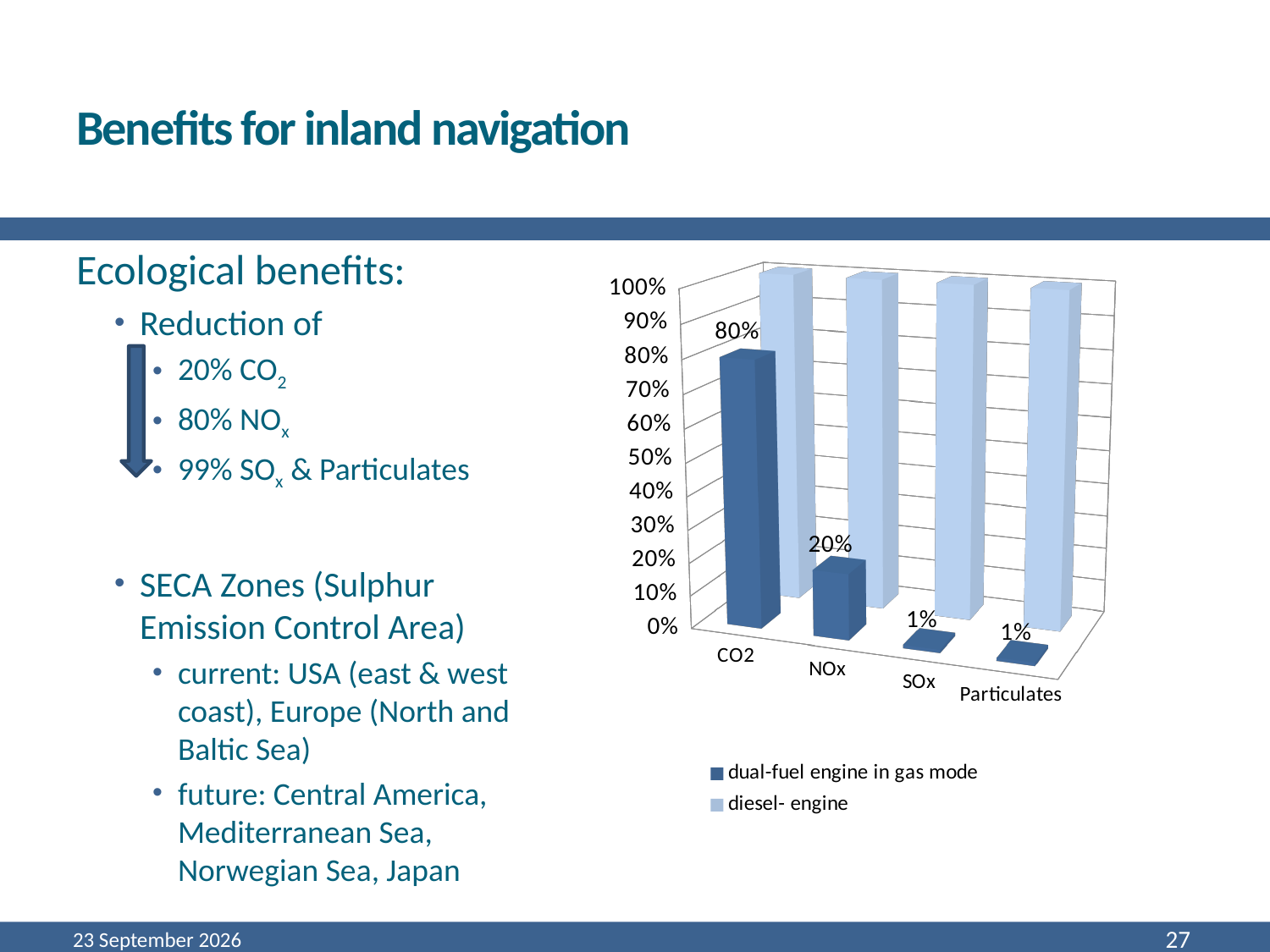
Do the dual-fuel engine in gas mode values rise or fall from CO2 to Particulates along the x axis? fall Which category has the highest value in the dual-fuel engine in gas mode series? CO2 What is the value for NOx in the dual-fuel engine in gas mode series? 20% In the dual-fuel engine in gas mode series, which is larger: the value for NOx or the value for Particulates? NOx What is the difference between the dual-fuel engine in gas mode values for CO2 and NOx? 60% What is the value for CO2 in the dual-fuel engine in gas mode series? 80% How many series does the chart legend list? 2 What kind of chart is shown on the slide? bar chart How many categories are shown on the x axis of the chart? 4 What is the value for SOx in the dual-fuel engine in gas mode series? 1% Is the diesel- engine value for CO2 greater or less than 50%? greater Which series is shown in the darker blue colour in the chart? dual-fuel engine in gas mode